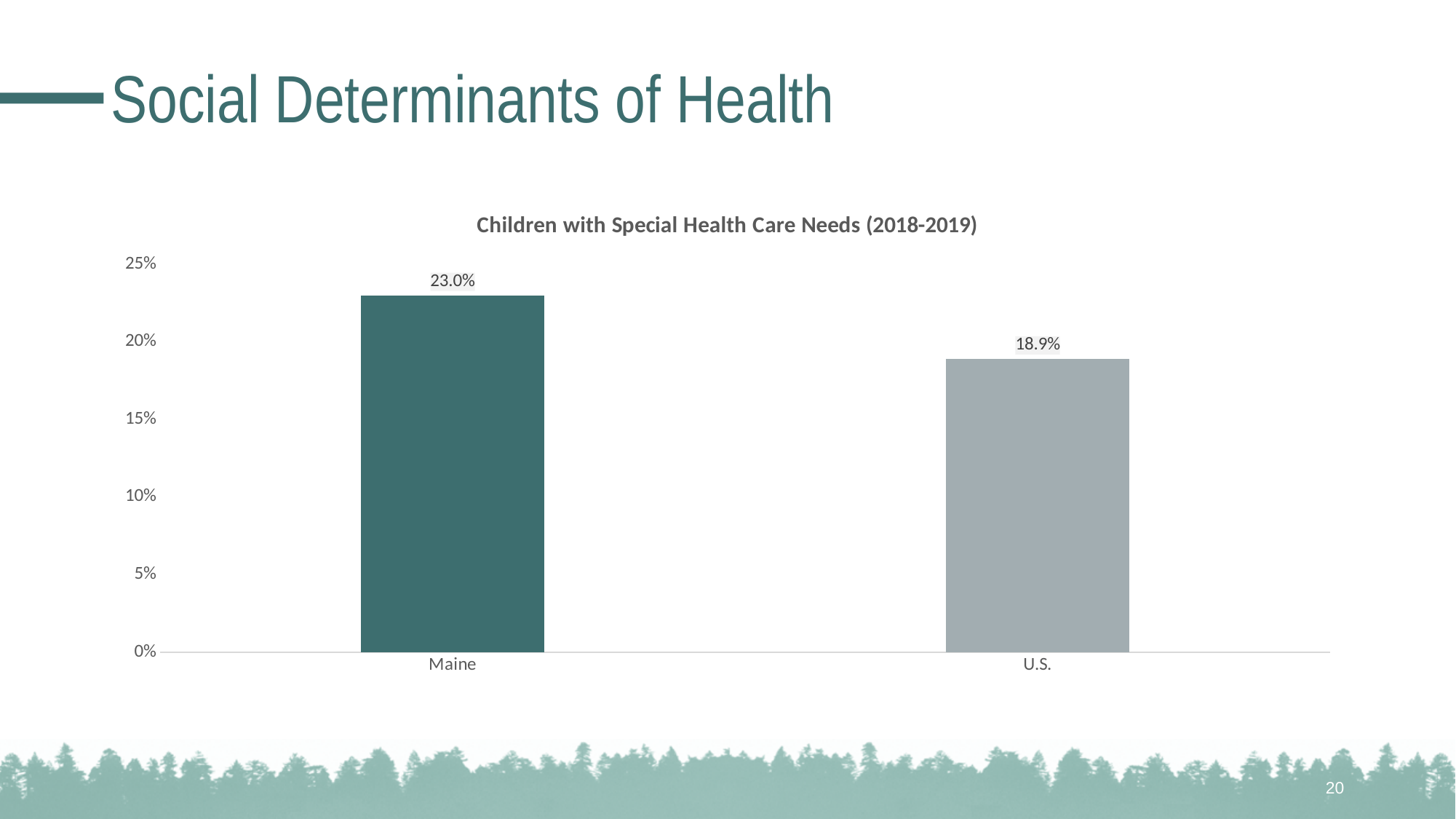
Is the value for Maine greater or less than 20%? greater Which category has the lowest value in the chart? U.S. What kind of chart is shown on the slide? bar chart What is the value for U.S. in the Children with Special Health Care Needs chart? 18.9% Is the value for U.S. greater or less than 20%? less What is the value for Maine in the Children with Special Health Care Needs chart? 23.0% Which is larger, the value for Maine or the value for U.S.? Maine What is the title of the chart? Children with Special Health Care Needs (2018-2019) What is the highest value shown on the vertical axis of the chart? 25% Which category has the highest value in the chart? Maine How many categories are shown in the chart? 2 What is the difference between the Maine and U.S. values? 4.1%